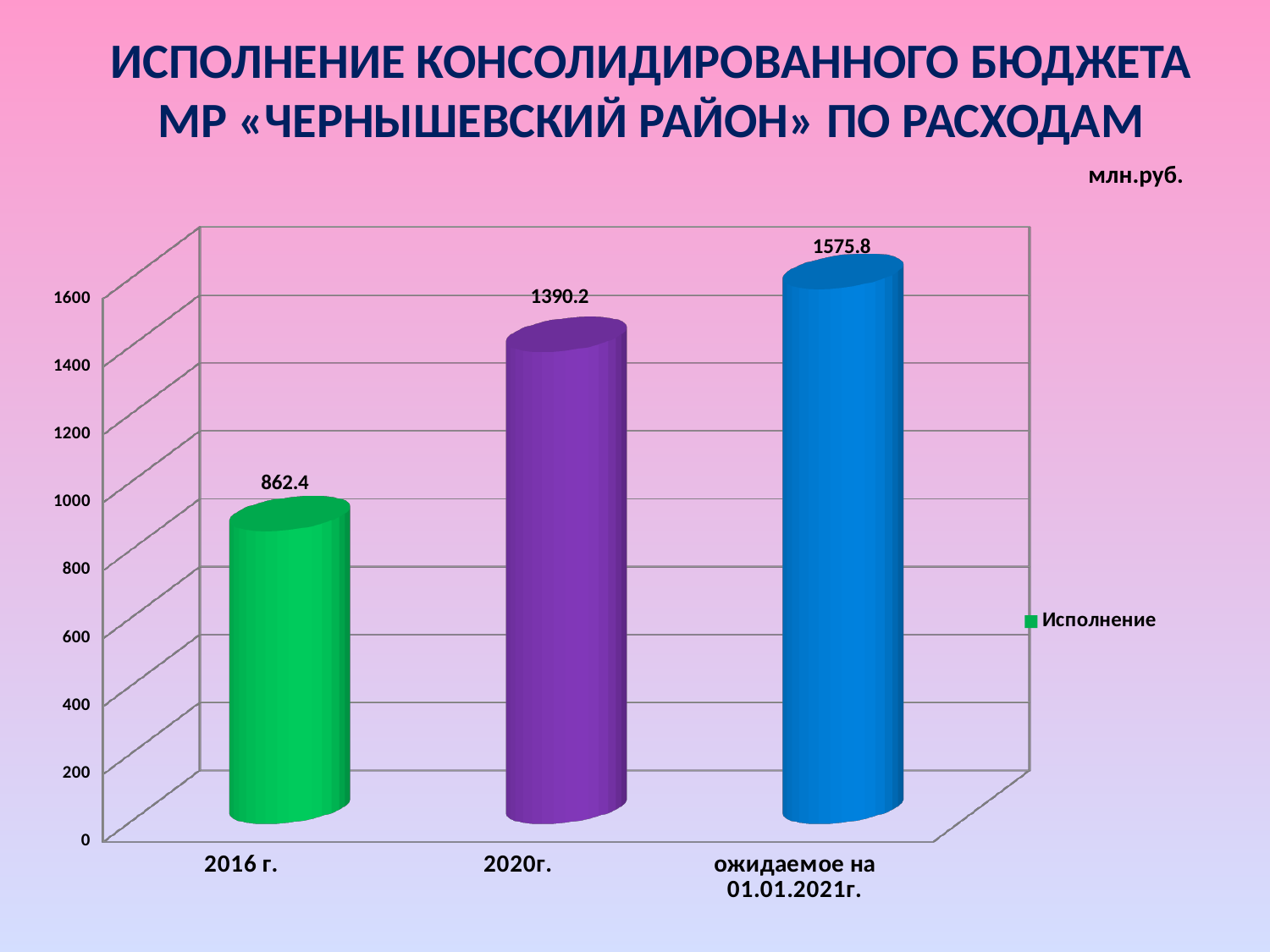
What kind of chart is shown on the slide? bar chart What is the value for 2016 г.? 862.4 What is the difference between the values for 2020г. and 2016 г.? 527.8 What is the value for ожидаемое на 01.01.2021г.? 1575.8 What is the value for 2020г.? 1390.2 How many categories are shown on the x axis? 3 What is the difference between the values for ожидаемое на 01.01.2021г. and 2020г.? 185.6 Which is larger, the value for 2016 г. or the value for 2020г.? 2020г. Do the values rise or fall from left to right along the x axis? rise How many series does the legend list? 1 Which category has the lowest value? 2016 г. Which category has the highest value? ожидаемое на 01.01.2021г.